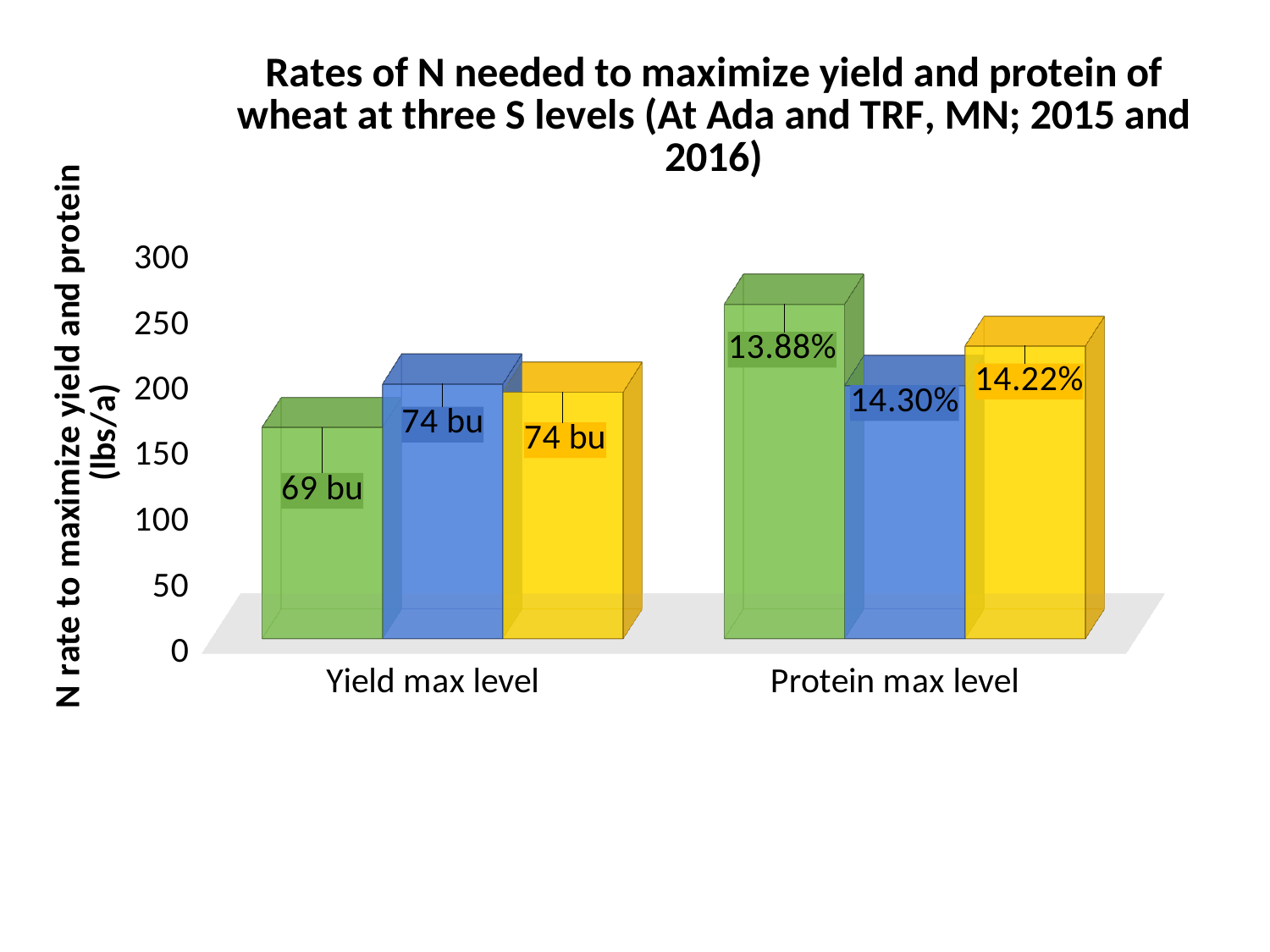
What label is printed on the green bar in the Yield max level category? 69 bu What label is printed on the green bar in the Protein max level category? 13.88% Is the N rate for the green bar in the Yield max level category greater or less than 200? less How many categories are shown on the x axis? 2 How many bars are plotted for the Yield max level category? 3 What is the label of the vertical axis? N rate to maximize yield and protein (lbs/a) Which bar is the shortest in the Yield max level category? the green bar What kind of chart is shown on the slide? bar chart Which bar is the tallest in the Protein max level category? the green bar What label is printed on the blue bar in the Yield max level category? 74 bu What label is printed on the yellow bar in the Protein max level category? 14.22% What label is printed on the blue bar in the Protein max level category? 14.30%